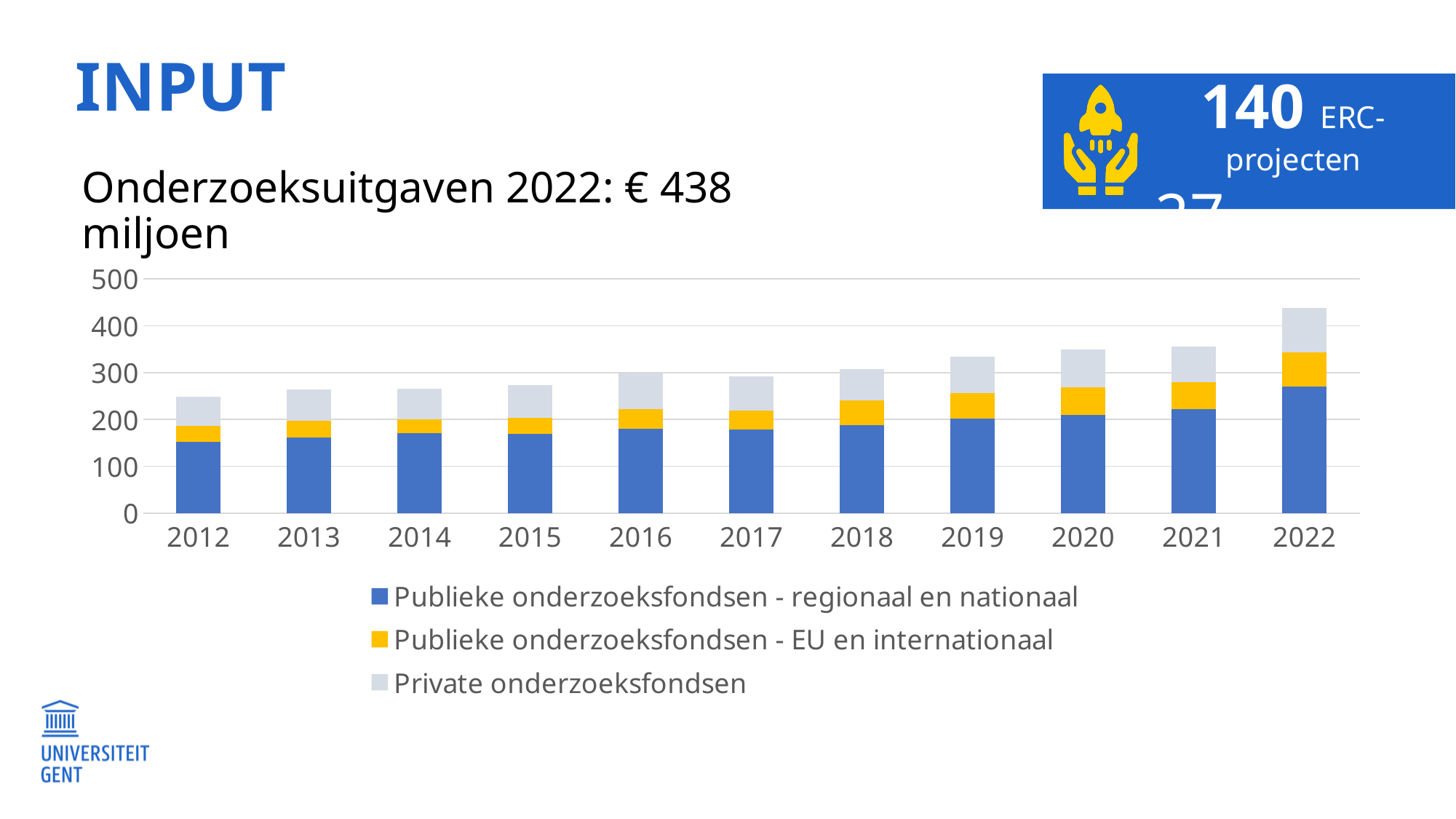
Is the total bar for 2022 greater or less than 400? greater What kind of chart is shown on the slide? bar chart Is the total bar for 2019 greater or less than 300? greater Which year has the lowest total bar in the chart? 2012 Is the value of 'Publieke onderzoeksfondsen - regionaal en nationaal' for 2022 greater or less than 200? greater Do the total bar heights generally rise or fall from 2012 to 2022? rise Which year has the larger total bar, 2012 or 2022? 2022 How many series does the chart legend list? 3 Which series is shown in yellow in the chart legend? Publieke onderzoeksfondsen - EU en internationaal How many years are shown on the x axis of the chart? 11 Which year has the highest total bar in the chart? 2022